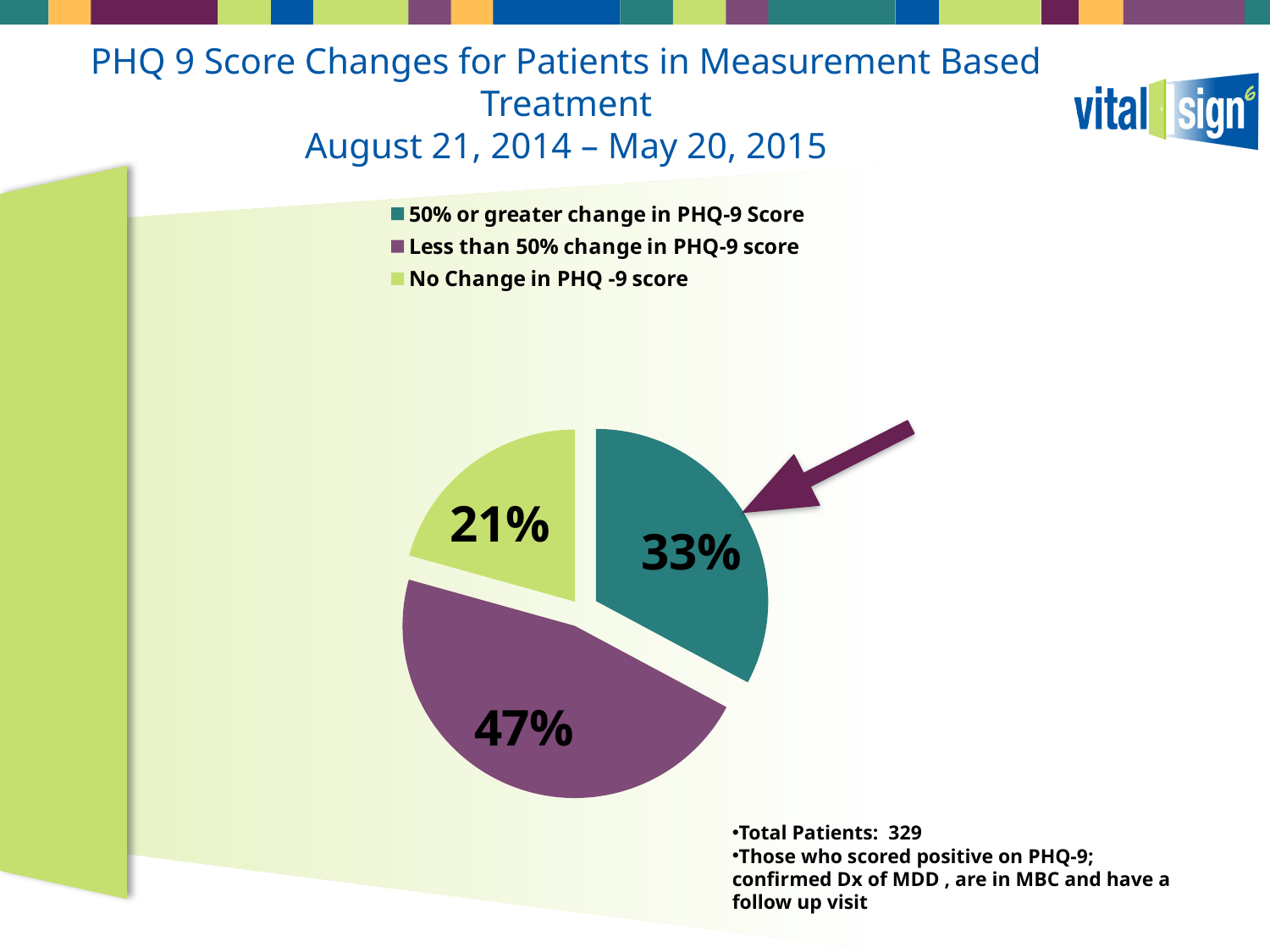
Which is larger: the share with 50% or greater change in PHQ-9 score or the share with no change? 50% or greater change in PHQ-9 Score What share of patients had less than 50% change in PHQ-9 score? 47% What is the difference in percentage points between the 'Less than 50% change' slice and the '50% or greater change' slice? 14 What is the total number of patients stated on the slide? 329 How many slices does the pie chart have? 3 Which category has the smallest slice of the pie? No Change in PHQ -9 score How many entries does the legend list? 3 What colour is the slice for 'No Change in PHQ -9 score'? Light green What share of patients had no change in PHQ-9 score? 21% What share of patients had a 50% or greater change in PHQ-9 score? 33% Which category has the largest slice of the pie? Less than 50% change in PHQ-9 score What kind of chart is shown on the slide? Pie chart